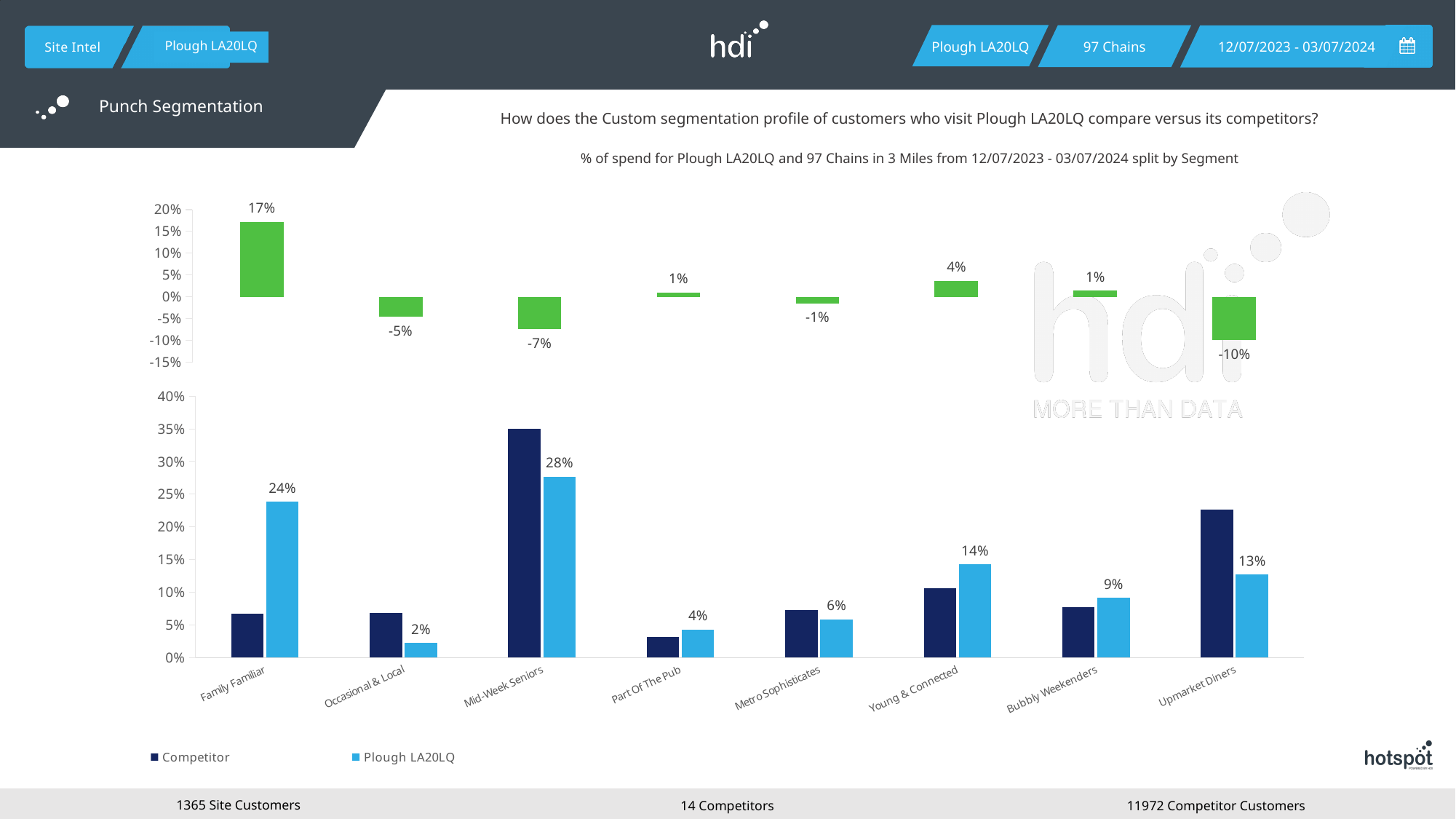
In the bottom chart, which is larger for Upmarket Diners: the Competitor bar or the Plough LA20LQ bar? Competitor How many segments are shown on the x axis of the bottom chart? 8 In the bottom chart, what is the difference between the Plough LA20LQ values for Family Familiar and Bubbly Weekenders? 15% In the bottom chart, what is the Plough LA20LQ value for Young & Connected? 14% How many series does the legend of the bottom chart list? 2 In the bottom chart, is the Competitor value for Mid-Week Seniors greater or less than 30%? greater In the bottom chart, which segment has the lowest Plough LA20LQ value? Occasional & Local In the top chart, what is the value shown for Upmarket Diners? -10% In the bottom chart, what is the Plough LA20LQ value for Mid-Week Seniors? 28% In the bottom chart, which segment has the highest Plough LA20LQ value? Mid-Week Seniors In the top chart, which segment has the lowest value? Upmarket Diners In the top chart, what is the value shown for Family Familiar? 17%